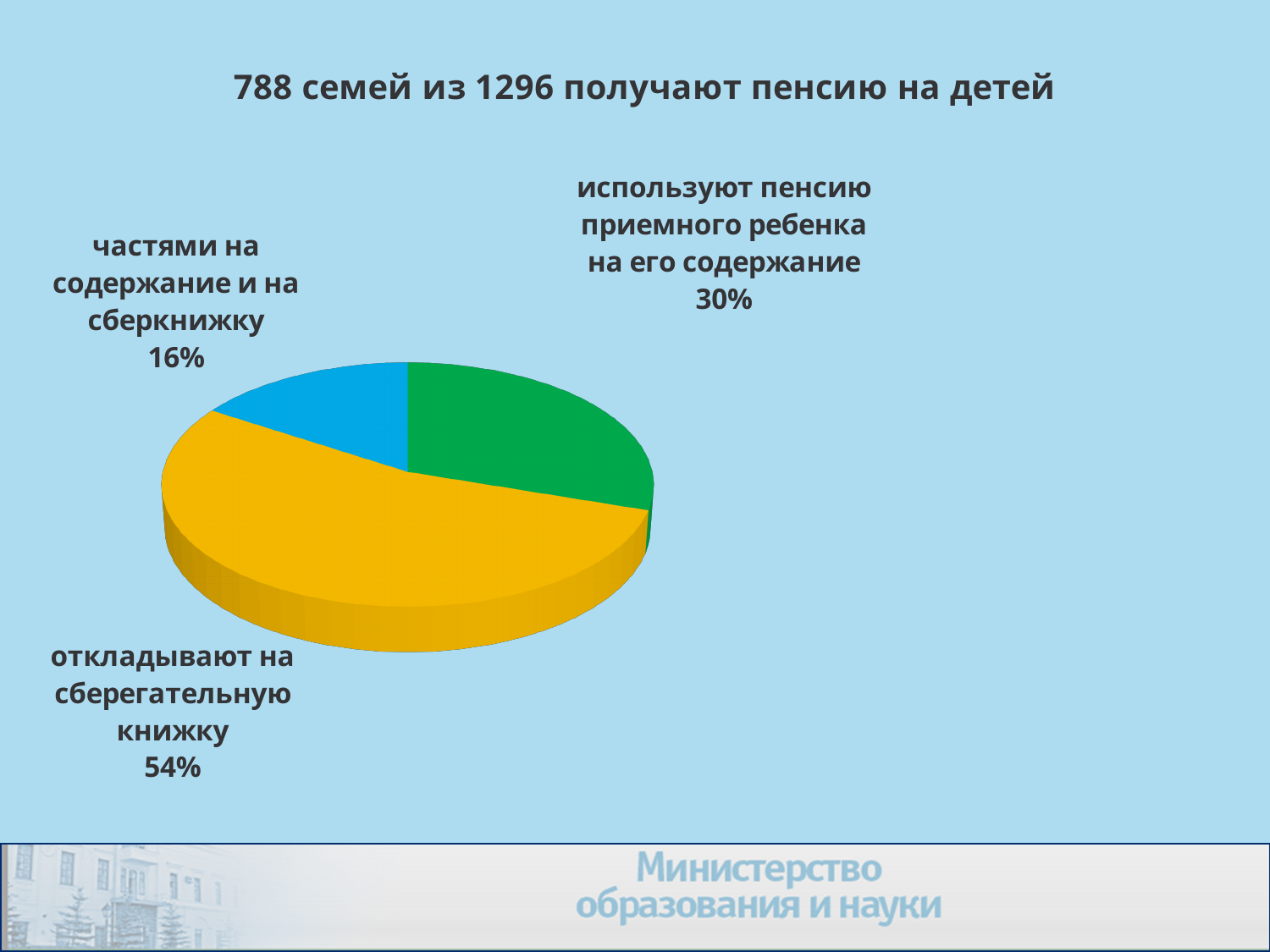
What share of the pie is labelled "откладывают на сберегательную книжку"? 54% Which is larger: the share for "используют пенсию приемного ребенка на его содержание" or the share for "частями на содержание и на сберкнижку"? используют пенсию приемного ребенка на его содержание What is the title of the slide above the chart? 788 семей из 1296 получают пенсию на детей How many slices does the pie chart have? 3 What is the difference in percentage points between the "используют пенсию приемного ребенка на его содержание" slice and the "частями на содержание и на сберкнижку" slice? 14% What share of the pie is labelled "частями на содержание и на сберкнижку"? 16% What colour is the slice for "откладывают на сберегательную книжку"? yellow Which category has the largest slice of the pie? откладывают на сберегательную книжку What share of the pie is labelled "используют пенсию приемного ребенка на его содержание"? 30% What is the difference in percentage points between the "откладывают на сберегательную книжку" slice and the "используют пенсию приемного ребенка на его содержание" slice? 24% Which category has the smallest slice of the pie? частями на содержание и на сберкнижку What kind of chart is shown on the slide? pie chart